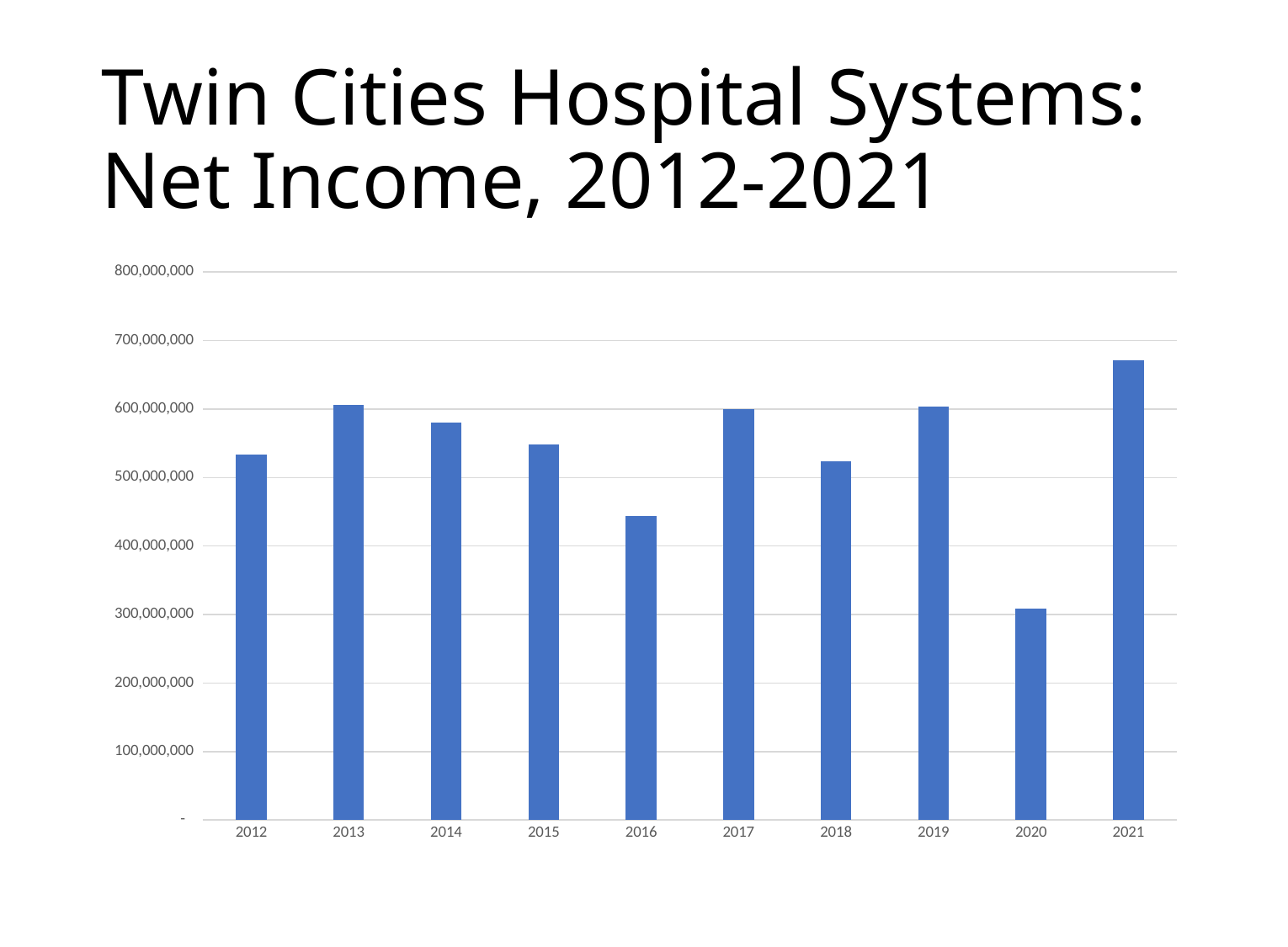
What kind of chart is shown on the slide? Bar chart Which year has the lowest net income? 2020 How many years are plotted on the x axis? 10 Is the value for 2016 greater or less than 500,000,000? less Is the value for 2021 greater or less than 600,000,000? greater Is the value for 2012 greater or less than 500,000,000? greater Which year has the larger net income, 2016 or 2017? 2017 What is the title of the slide? Twin Cities Hospital Systems: Net Income, 2012-2021 What colour are the bars in the chart? Blue Which year has the highest net income? 2021